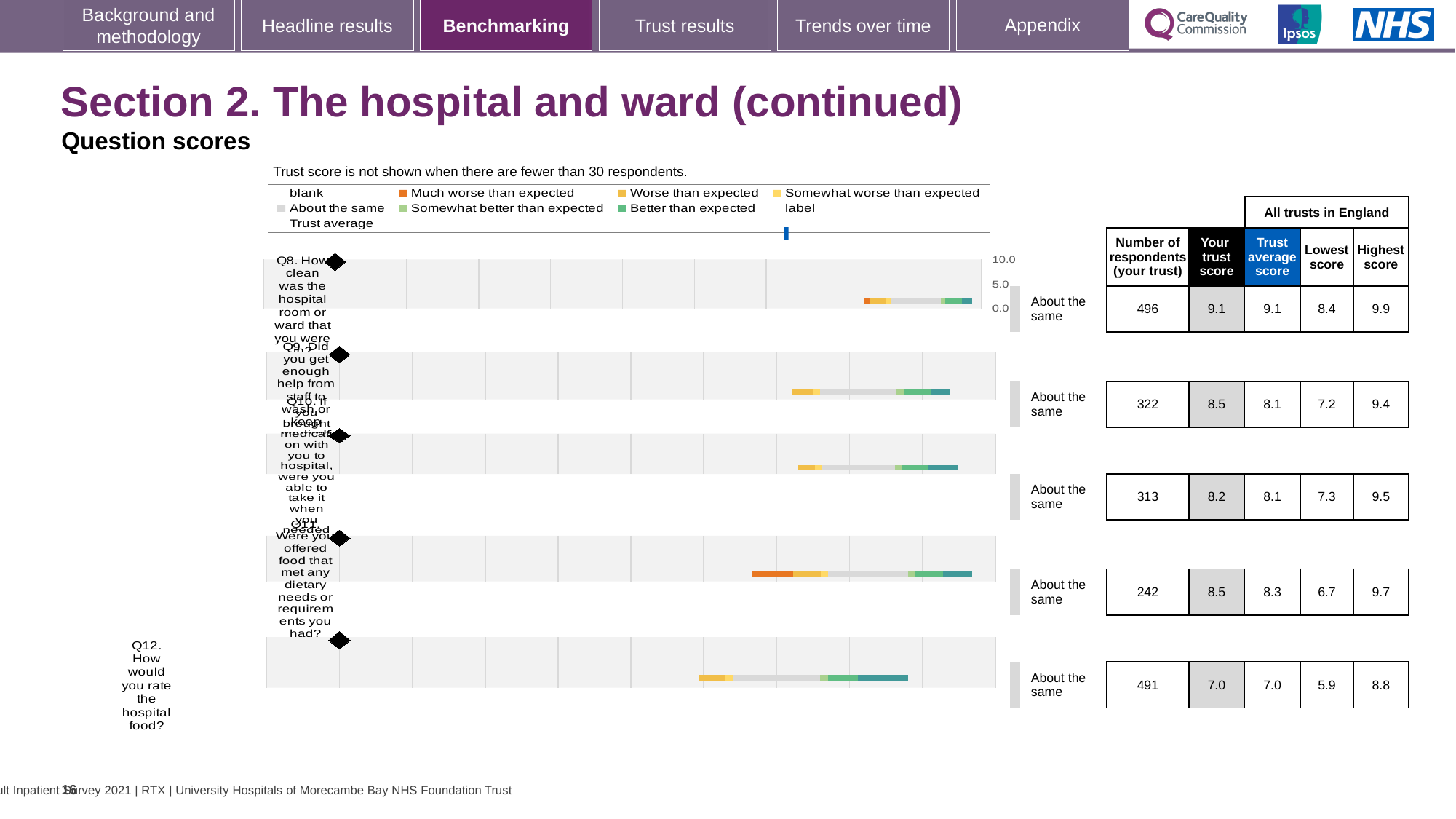
How many questions (categories) are plotted in the chart? 5 How many respondents from your trust answered Q12 (How would you rate the hospital food)? 491 For Q11, what is the difference between the highest score and the lowest score across all trusts in England? 3.0 What is the 'Your trust score' for Q8 (How clean was the hospital room or ward)? 9.1 What is the lowest score across all trusts in England for Q12? 5.9 Which legend entry is shown in dark orange? Much worse than expected Is the trust score for Q12 greater or less than 5.0? greater What kind of chart is used to show the question scores for Q8 to Q12? Bar chart What benchmark category label is shown next to Q10? About the same Which question has the highest 'Your trust score'? Q8 For Q9, which is larger: your trust score or the trust average score? Your trust score Which question has the lowest 'Your trust score'? Q12